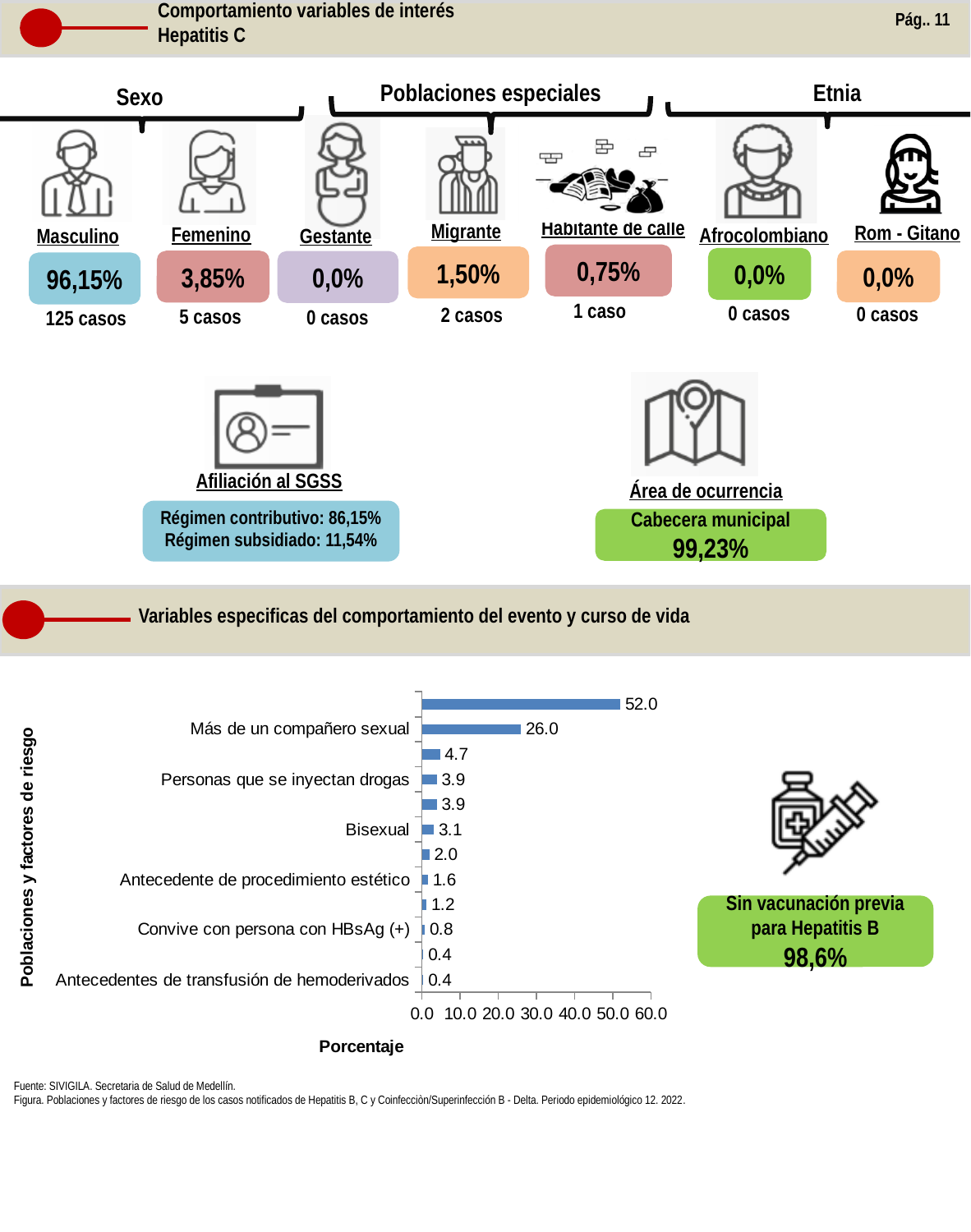
What is the value for "Convive con persona con HBsAg (+)"? 0.8 What is the value for "Antecedente de procedimiento estético"? 1.6 What is the value for "Bisexual"? 3.1 Which has a larger value, "Personas que se inyectan drogas" or "Bisexual"? Personas que se inyectan drogas What is the value for "Personas que se inyectan drogas"? 3.9 What is the difference between the values for "Más de un compañero sexual" and "Personas que se inyectan drogas"? 22.1 What is the largest value shown in the bar chart? 52.0 What is the title of the x axis of the bar chart? Porcentaje What is the value for "Antecedentes de transfusión de hemoderivados"? 0.4 What type of chart is shown at the bottom of the slide? bar chart What is the value for "Más de un compañero sexual"? 26.0 How many bars are plotted in the bar chart? 12